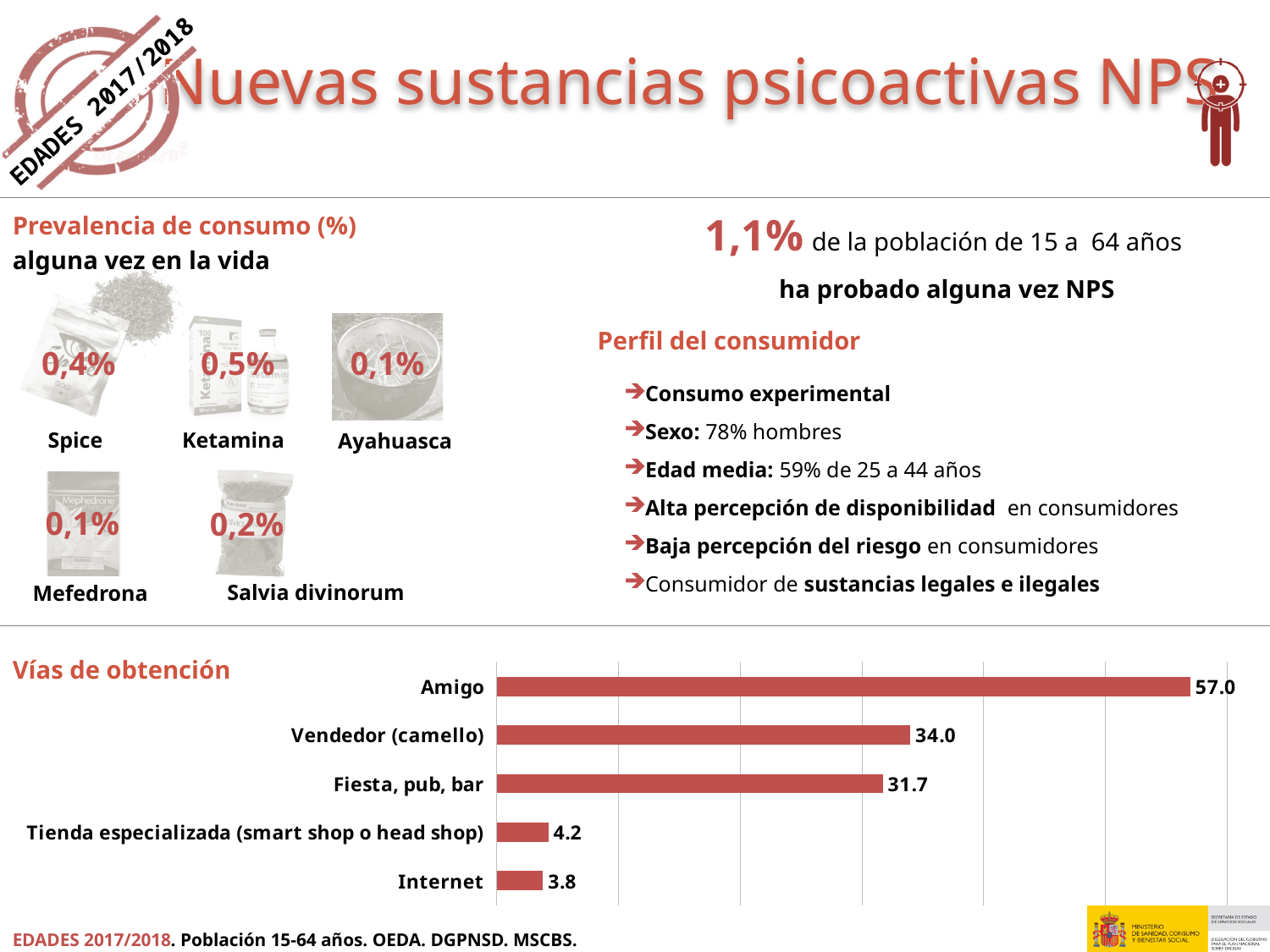
What kind of chart is the 'Vías de obtención' chart? Bar chart In the 'Vías de obtención' chart, what is the difference between the values for Tienda especializada (smart shop o head shop) and Internet? 0.4 In the 'Vías de obtención' chart, what is the difference between the values for Amigo and Vendedor (camello)? 23.0 In the 'Vías de obtención' chart, which category has the lowest value? Internet In the 'Vías de obtención' chart, what is the value for Tienda especializada (smart shop o head shop)? 4.2 In the 'Vías de obtención' chart, which is larger: the value for Vendedor (camello) or the value for Fiesta, pub, bar? Vendedor (camello) In the 'Vías de obtención' chart, what is the value for Amigo? 57.0 In the 'Vías de obtención' chart, what is the value for Fiesta, pub, bar? 31.7 In the 'Vías de obtención' chart, which category has the highest value? Amigo How many categories are shown in the 'Vías de obtención' chart? 5 In the 'Vías de obtención' chart, what is the value for Vendedor (camello)? 34.0 In the 'Vías de obtención' chart, what is the value for Internet? 3.8